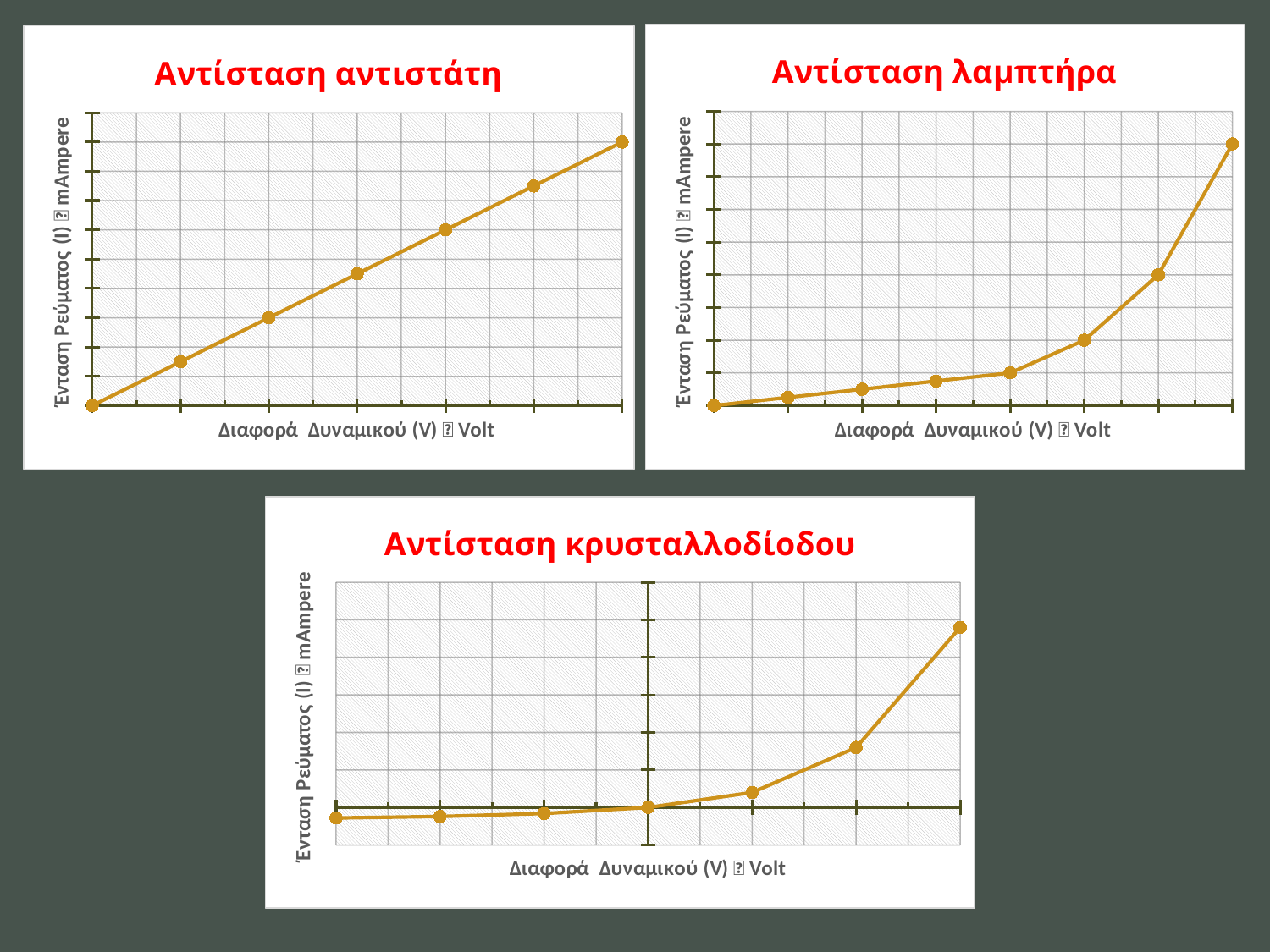
On the chart titled "Αντίσταση λαμπτήρα", is the highest plotted value at the leftmost or the rightmost point? rightmost How many data points are plotted on the chart titled "Αντίσταση λαμπτήρα"? 8 On the chart titled "Αντίσταση αντιστάτη", do the values rise or fall from left to right along the x axis? rise On the chart titled "Αντίσταση λαμπτήρα", do the values rise or fall from left to right along the x axis? rise On the chart titled "Αντίσταση κρυσταλλοδίοδου", do the values rise or fall from left to right along the x axis? rise On the chart titled "Αντίσταση αντιστάτη", is the lowest plotted value at the leftmost or the rightmost point? leftmost How many data points are plotted on the chart titled "Αντίσταση αντιστάτη"? 7 How many data points are plotted on the chart titled "Αντίσταση κρυσταλλοδίοδου"? 7 How many charts are shown on the slide? 3 What is the title of the chart at the bottom of the slide? Αντίσταση κρυσταλλοδίοδου What kind of chart is the chart titled "Αντίσταση αντιστάτη"? line chart What kind of chart is the chart titled "Αντίσταση κρυσταλλοδίοδου"? line chart